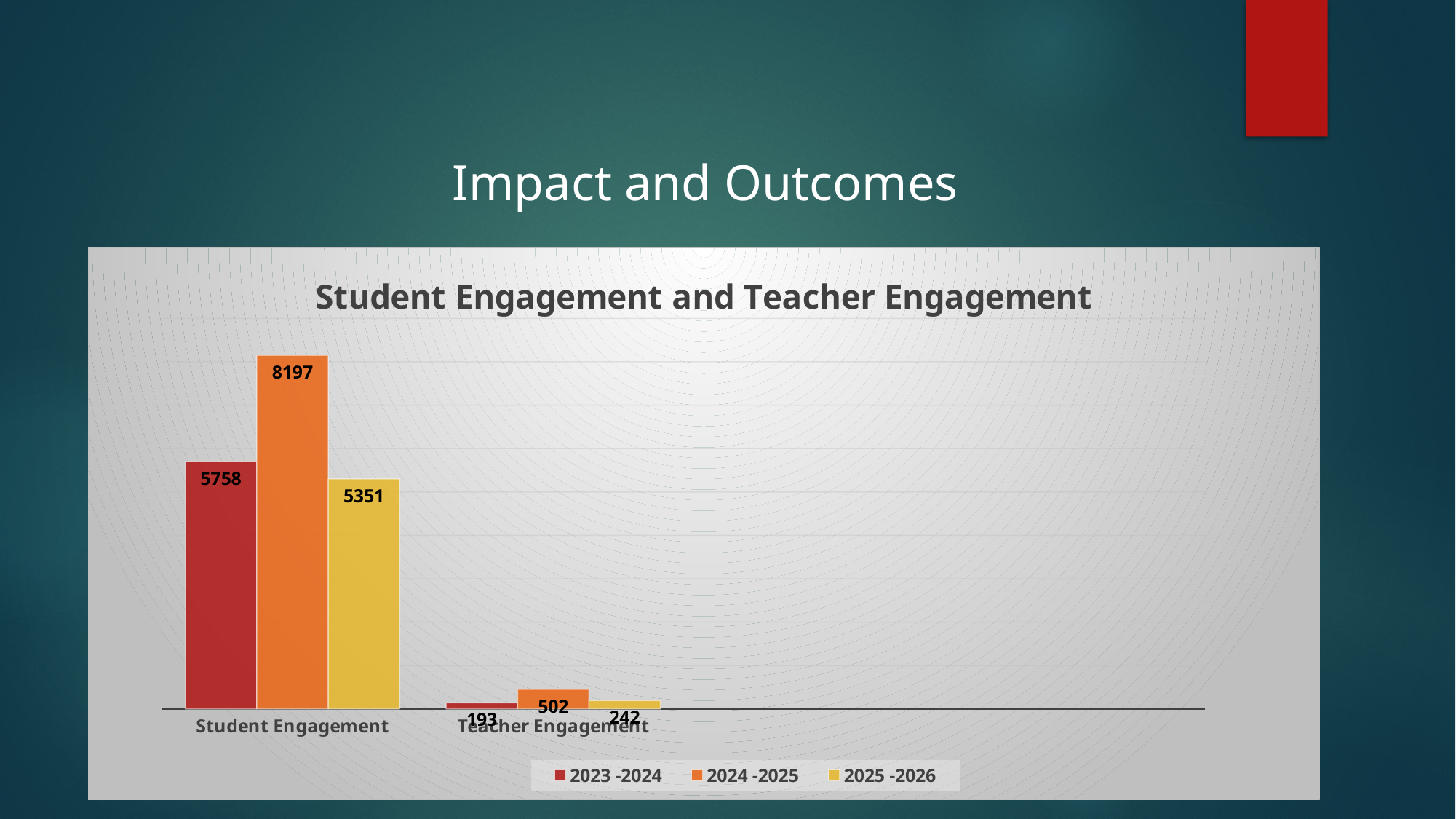
What kind of chart is shown on the slide? Bar chart Which is larger for Student Engagement: the 2023 -2024 value or the 2025 -2026 value? 2023 -2024 Which series has the highest value for Student Engagement? 2024 -2025 How many series does the legend list? 3 What is the value for Student Engagement in the 2024 -2025 series? 8197 Which series has the lowest value for Teacher Engagement? 2023 -2024 How many categories are shown on the x axis? 2 What is the difference between the 2024 -2025 and 2023 -2024 values for Student Engagement? 2439 What is the value for Teacher Engagement in the 2025 -2026 series? 242 What is the value for Student Engagement in the 2025 -2026 series? 5351 What is the difference between the 2024 -2025 and 2025 -2026 values for Teacher Engagement? 260 What is the value for Teacher Engagement in the 2023 -2024 series? 193